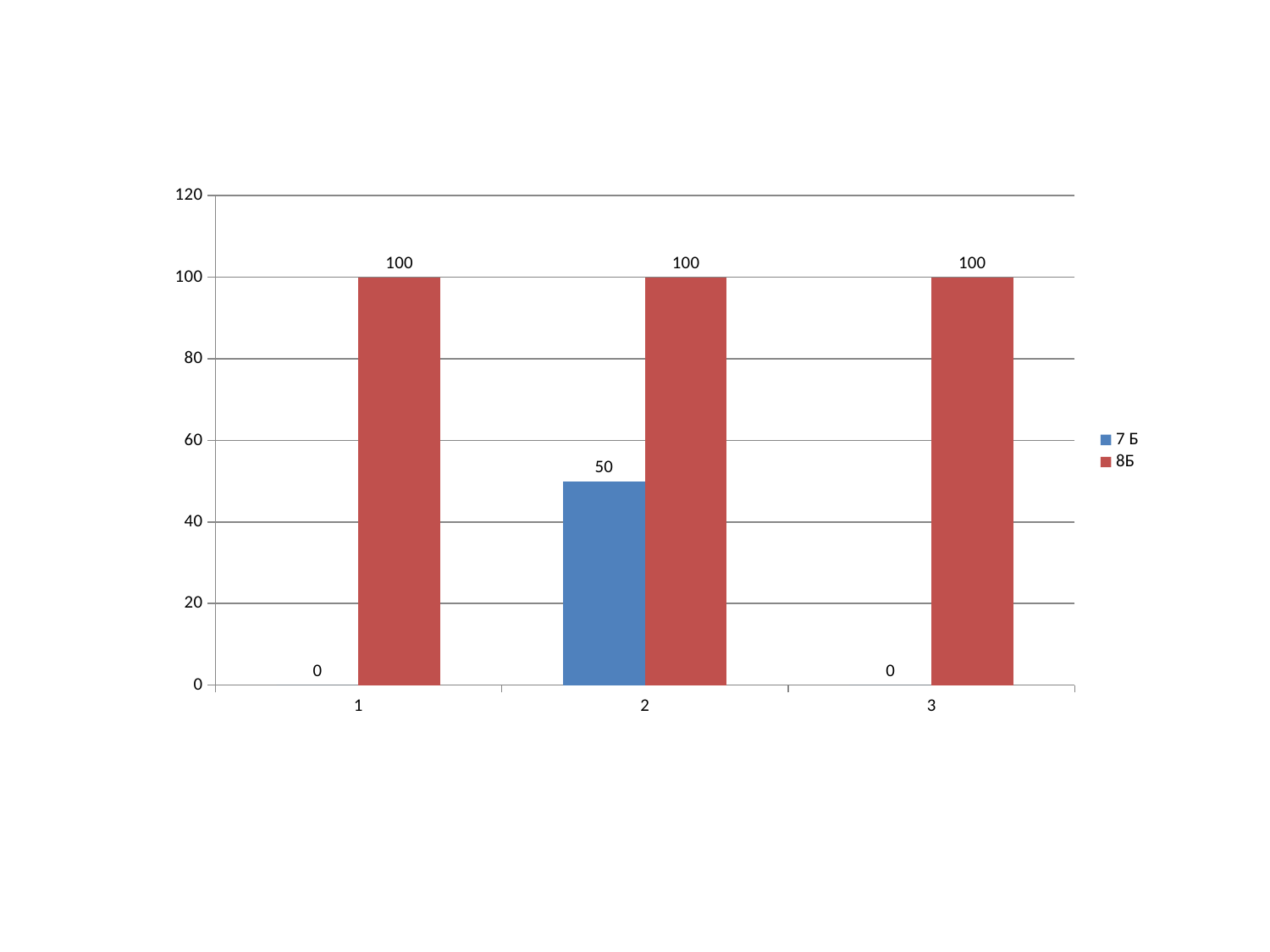
What kind of chart is shown on the slide? bar chart What are the two series names listed in the legend? 7 Б and 8Б What colour are the bars for series 8Б? red What is the value for series 8Б at category 3? 100 What is the value for series 7 Б at category 2? 50 What is the value for series 8Б at category 1? 100 How many series does the legend list? 2 Which is larger at category 2: the value for 7 Б or the value for 8Б? 8Б How many categories are shown on the x axis? 3 What is the difference between the 8Б and 7 Б values at category 2? 50 What is the value for series 7 Б at category 3? 0 Which category has the highest value for series 7 Б? 2